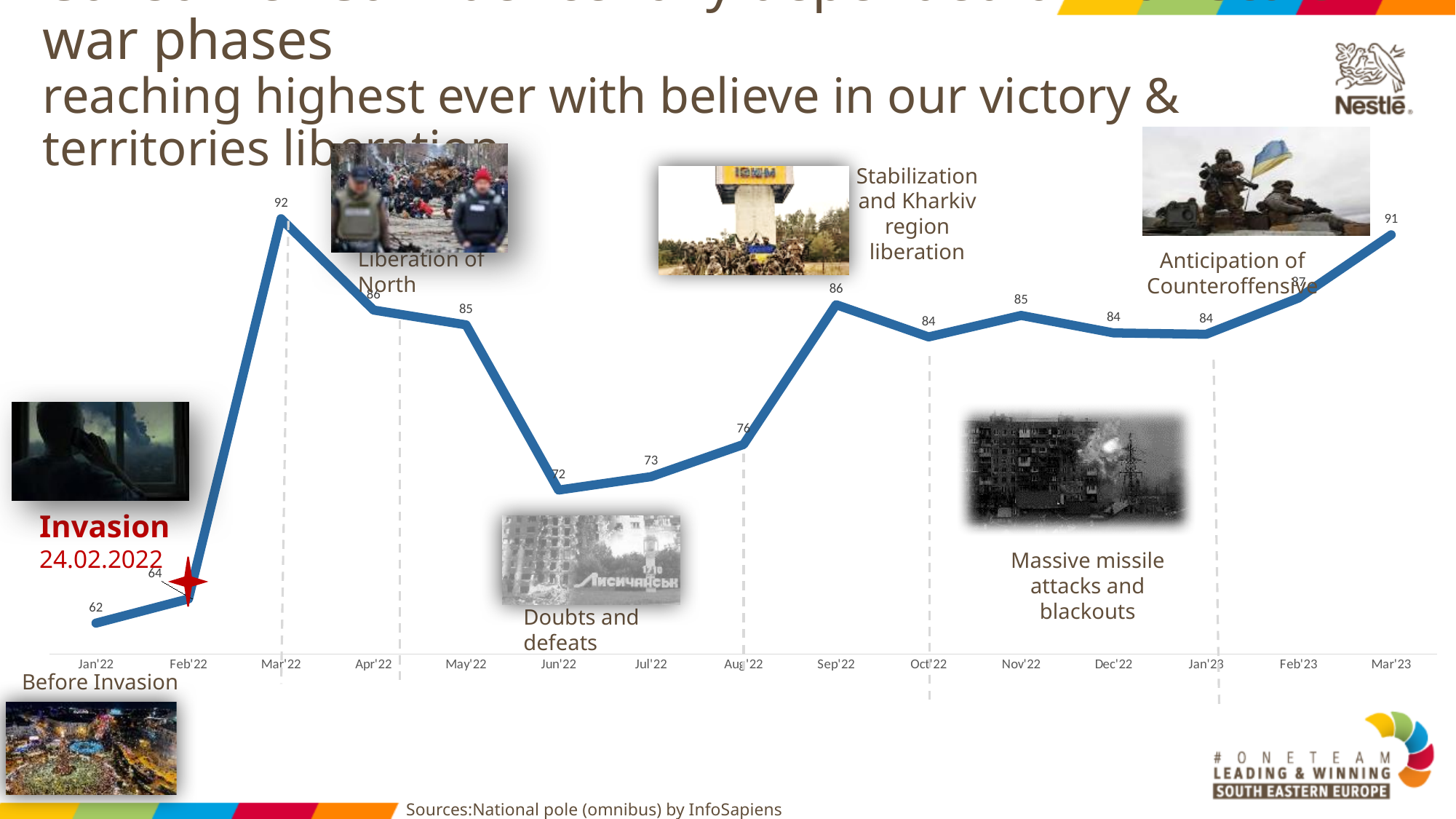
What kind of chart is shown on the slide? Line chart How many data points are plotted on the line? 15 What is the value plotted for Jan'22? 62 What is the value plotted for Jun'22? 72 Which month has the highest value on the chart? Mar'22 What is the value plotted for Sep'22? 86 What is the value plotted for Mar'23? 91 What is the value plotted for Mar'22? 92 Which is larger, the value for Aug'22 or the value for Jul'22? Aug'22 What is the difference between the values for Mar'23 and Jun'22? 19 Which month has the lowest value on the chart? Jan'22 What is the difference between the values for Mar'22 and Jan'22? 30